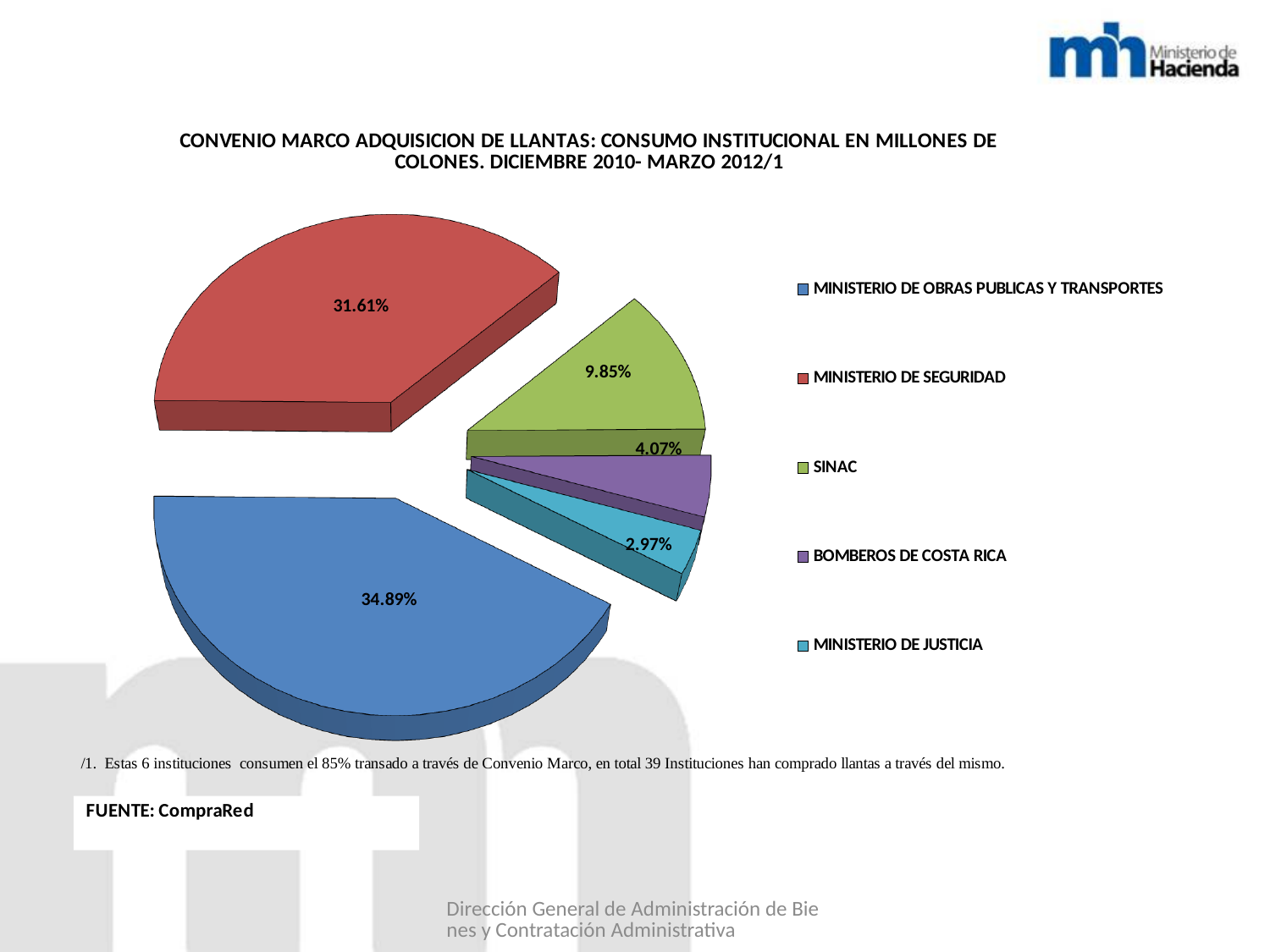
What share of the pie does BOMBEROS DE COSTA RICA have? 4.07% By how many percentage points does the share of MINISTERIO DE OBRAS PUBLICAS Y TRANSPORTES exceed that of MINISTERIO DE SEGURIDAD? 3.28 Which has the larger share, MINISTERIO DE SEGURIDAD or SINAC? MINISTERIO DE SEGURIDAD By how many percentage points does the share of SINAC exceed that of BOMBEROS DE COSTA RICA? 5.78 How many entries does the chart legend list? 5 What kind of chart is shown on the slide? pie chart What source is cited for the chart data? CompraRed What share of the pie does MINISTERIO DE JUSTICIA have? 2.97% Which institution has the largest slice of the pie? MINISTERIO DE OBRAS PUBLICAS Y TRANSPORTES What share of the pie does MINISTERIO DE SEGURIDAD have? 31.61% What share of the pie does SINAC have? 9.85% What share of the pie does MINISTERIO DE OBRAS PUBLICAS Y TRANSPORTES have? 34.89%